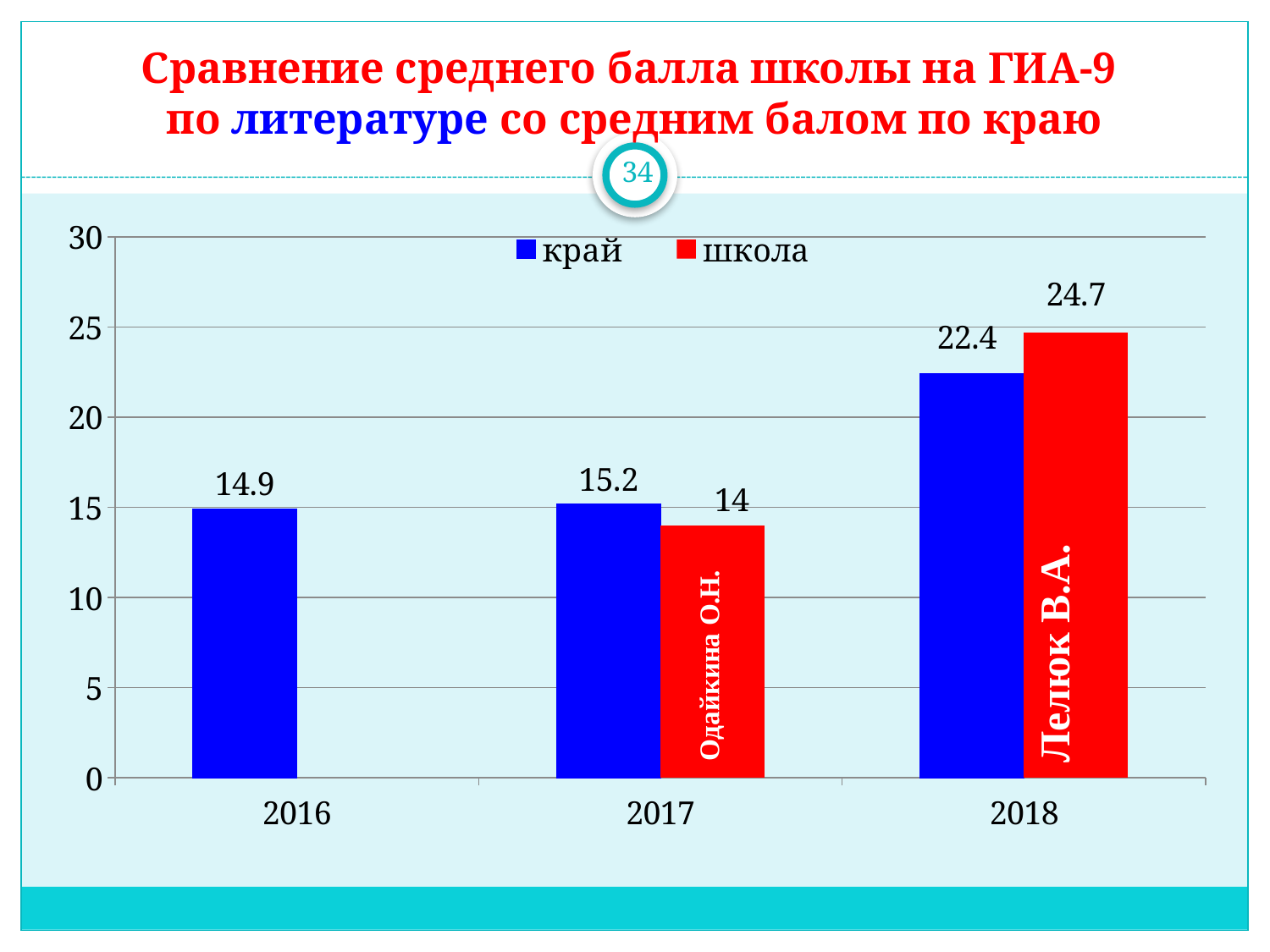
In which year is the value for край lowest? 2016 Does the value for край rise or fall from 2016 to 2018? rise What is the value for школа in 2017? 14 What is the difference between школа and край in 2018? 2.3 What is the value for школа in 2018? 24.7 What kind of chart is shown on the slide? bar chart Which is larger in 2017, край or школа? край How many series does the legend list? 2 How many years are shown on the x axis? 3 In which year is the value for край highest? 2018 What is the value for край in 2018? 22.4 What is the value for край in 2016? 14.9